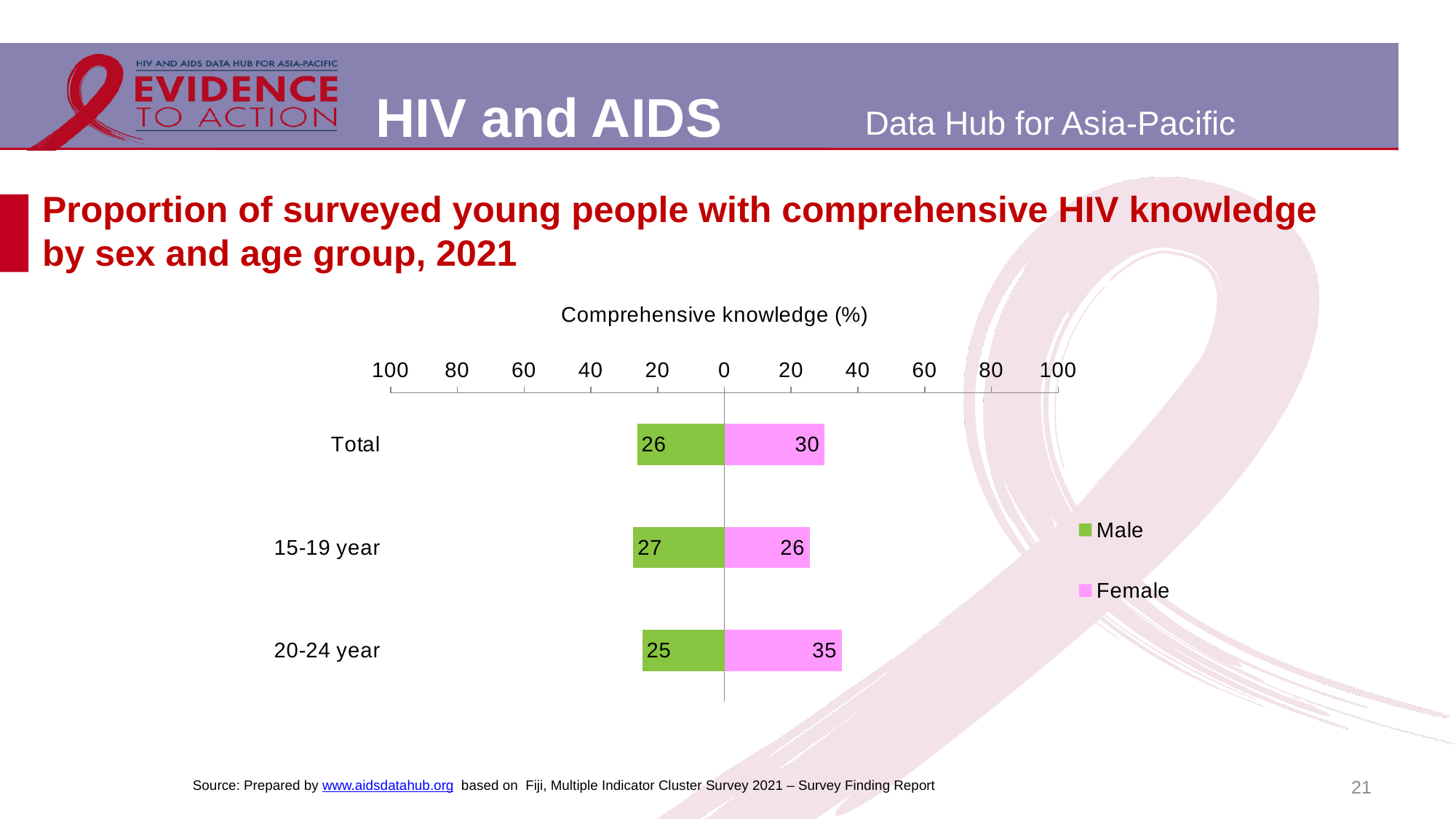
How many categories are shown on the y axis of the chart? 3 What is the difference between the Female and Male values for the 20-24 year group? 10 What is the Female value for the 20-24 year group? 35 Is the Female value for the 20-24 year group greater or less than 40? less Which category has the lowest Male value? 20-24 year Which age group has the highest Female value? 20-24 year What is the Female value for Total? 30 How many series does the legend list? 2 What is the Male value for the 20-24 year group? 25 What is the Male value for the 15-19 year group? 27 What kind of chart is shown on the slide? bar chart For the 15-19 year group, is the Male value or the Female value larger? Male